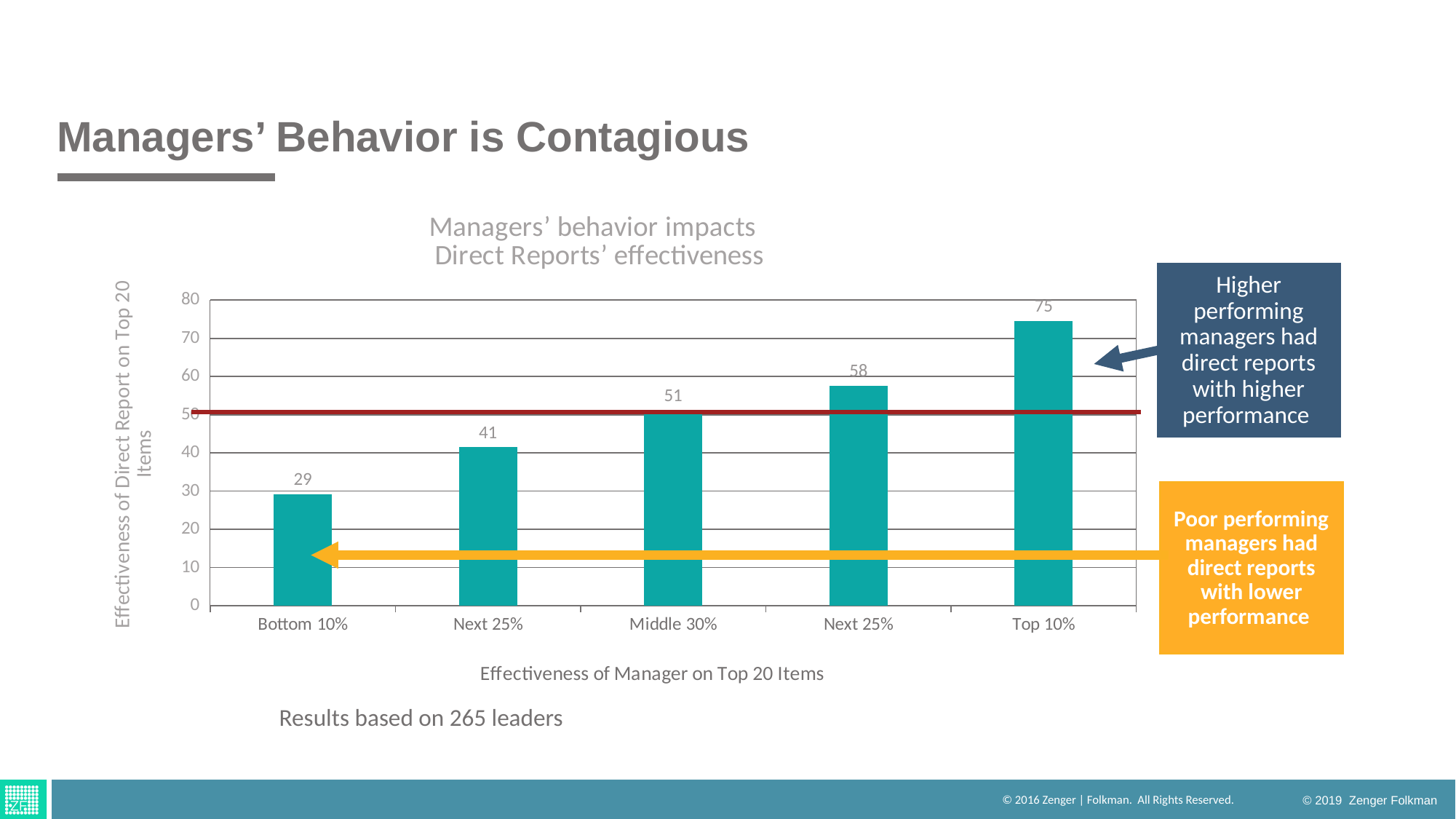
Which category has the lowest value? Bottom 10% Do the values rise or fall from left to right along the x axis? Rise What kind of chart is shown? Bar chart Which category has the highest value? Top 10% What is the value for Bottom 10%? 29 What is the value for Middle 30%? 51 What is the difference between the values for Middle 30% and Bottom 10%? 22 How many categories are shown on the x axis? 5 Which is larger, the value for Middle 30% or the value for Top 10%? Top 10% What is the value for Top 10%? 75 What is the difference between the values for Top 10% and Bottom 10%? 46 What is the value of the Next 25% bar immediately to the right of Middle 30%? 58